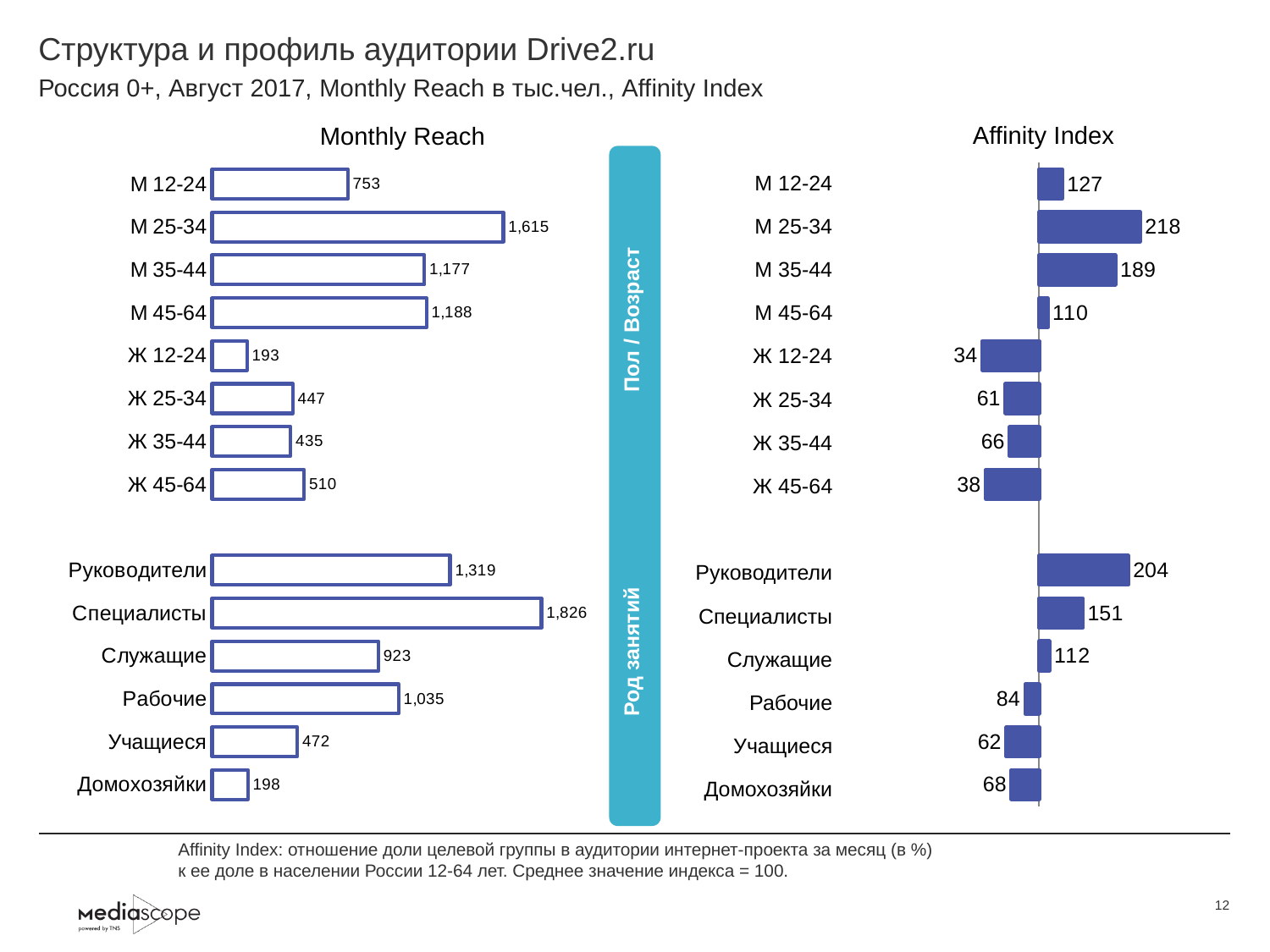
In the Monthly Reach chart, what is the difference between Специалисты and Руководители? 507 In the Affinity Index chart, which category has the lowest value? Ж 12-24 In the Monthly Reach chart, what is the value for Рабочие? 1,035 In the Monthly Reach chart, what is the value for М 25-34? 1,615 In the Monthly Reach chart, which is larger: Ж 25-34 or Ж 45-64? Ж 45-64 In the Affinity Index chart, which is larger: М 35-44 or М 45-64? М 35-44 What kind of chart is the Monthly Reach chart? Bar chart In the Affinity Index chart, what is the difference between М 25-34 and Ж 25-34? 157 How many categories are plotted in the Affinity Index chart? 14 In the Affinity Index chart, what is the value for Домохозяйки? 68 In the Monthly Reach chart, which category has the highest value? Специалисты In the Affinity Index chart, what is the value for Руководители? 204